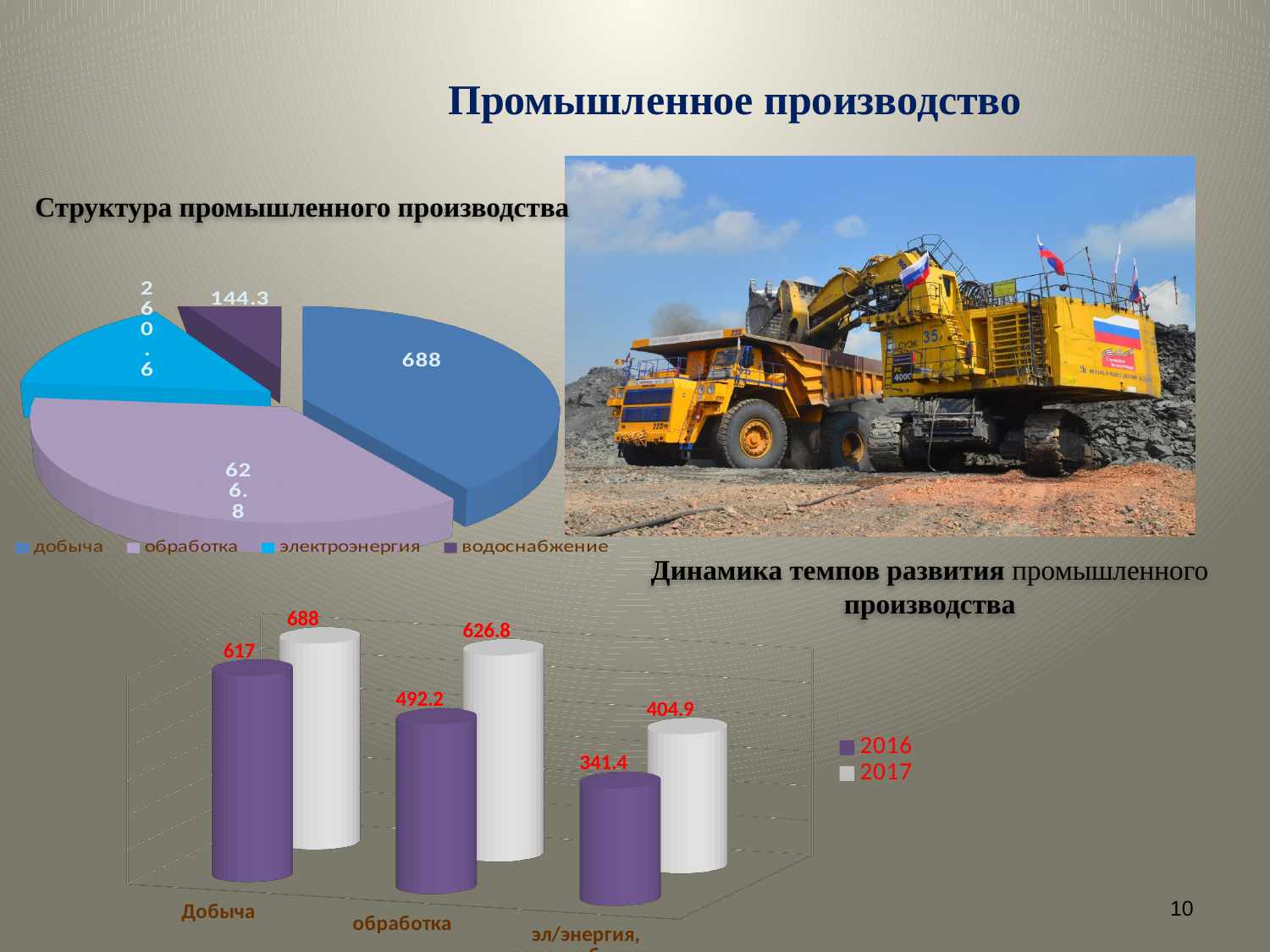
What kind of chart is the lower chart 'Динамика темпов развития промышленного производства'? bar chart In the bar chart 'Динамика темпов развития промышленного производства', what is the 2017 value for обработка? 626.8 In the pie chart 'Структура промышленного производства', what is the value for добыча? 688 In the pie chart 'Структура промышленного производства', which category has the smallest slice? водоснабжение In the pie chart 'Структура промышленного производства', which category has the largest slice? добыча In the pie chart 'Структура промышленного производства', what is the value for водоснабжение? 144.3 In the bar chart 'Динамика темпов развития промышленного производства', which is larger for эл/энергия: the 2016 value or the 2017 value? 2017 In the pie chart 'Структура промышленного производства', what is the difference between the values for обработка and электроэнергия? 366.2 In the bar chart 'Динамика темпов развития промышленного производства', what is the difference between the 2017 and 2016 values for обработка? 134.6 In the bar chart 'Динамика темпов развития промышленного производства', what is the 2016 value for Добыча? 617 In the pie chart 'Структура промышленного производства', how many categories does the legend list? 4 In the bar chart 'Динамика темпов развития промышленного производства', how many series does the legend list? 2